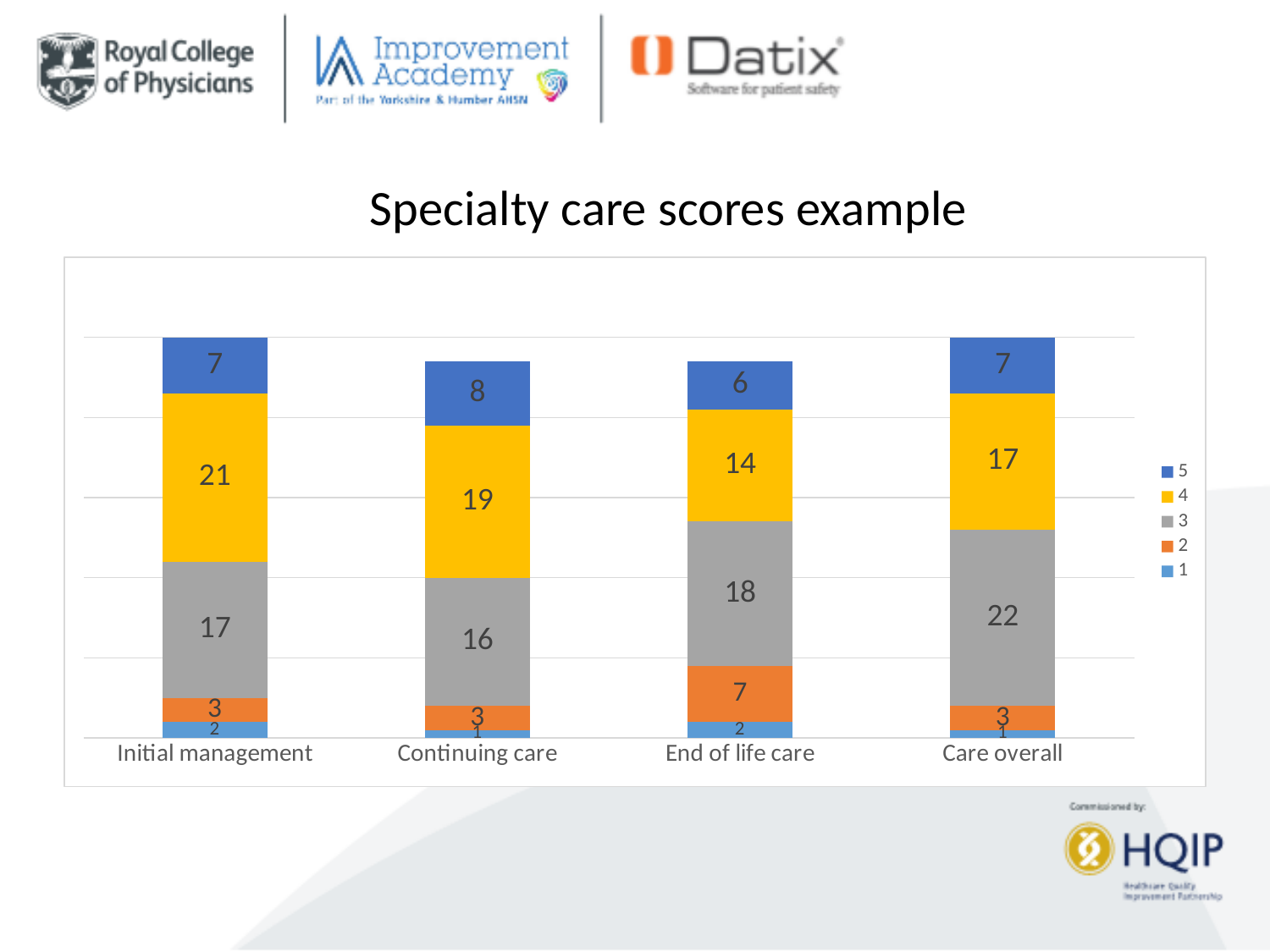
What is the difference between the series 4 values for Initial management and End of life care? 7 Which is larger: the series 3 value for End of life care or the series 3 value for Continuing care? End of life care Which category has the highest value for series 3? Care overall What is the value of series 4 for Initial management? 21 What type of chart is shown on the slide? Stacked bar chart What is the value of series 2 for End of life care? 7 What is the value of series 3 for Care overall? 22 What is the total of the stacked bar for Initial management? 50 How many categories are shown on the x axis? 4 What is the value of series 5 for Continuing care? 8 Which category has the lowest value for series 4? End of life care How many series does the legend list? 5